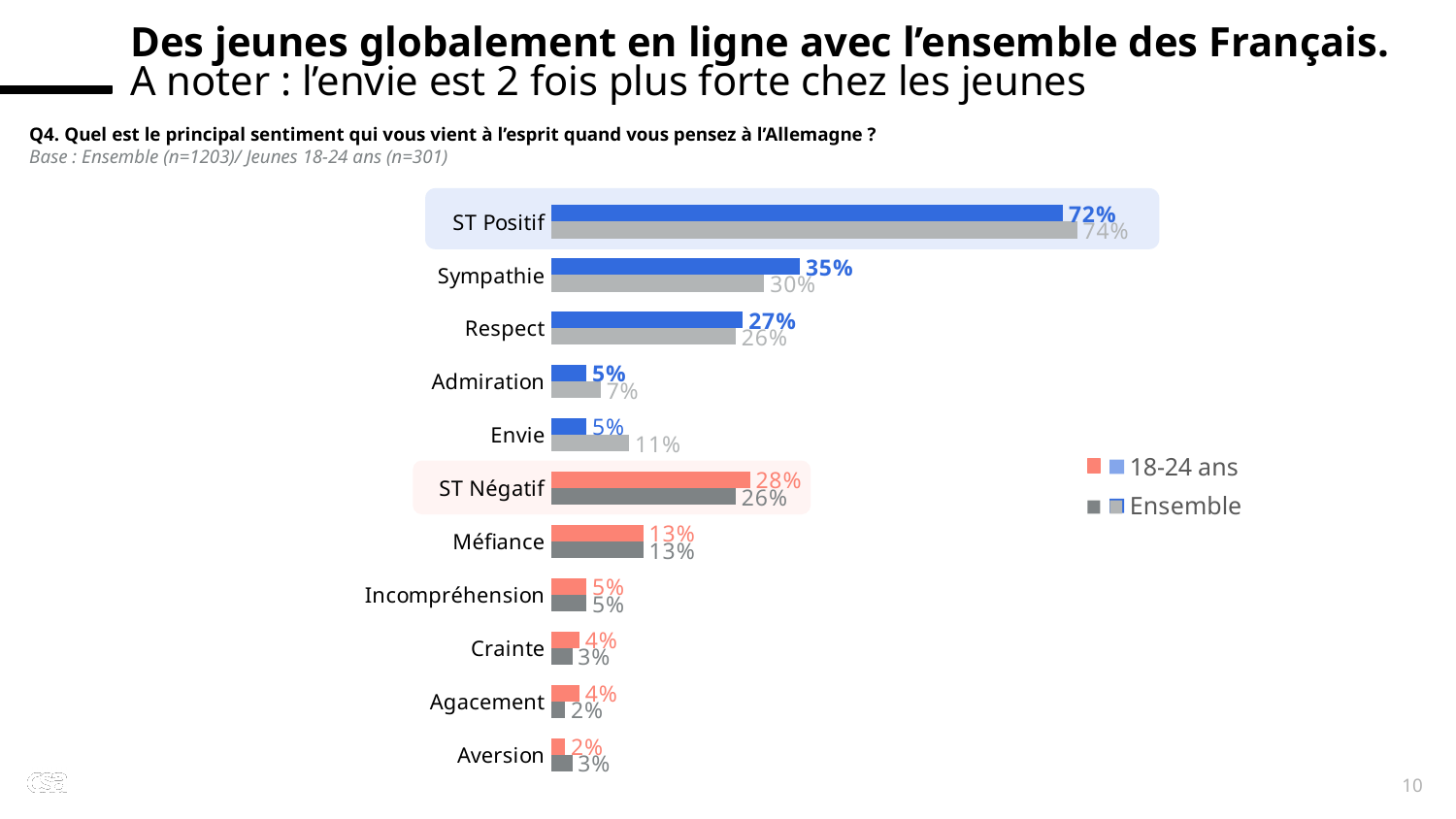
What is the value for Envie in the Ensemble series? 11% What are the two series named in the legend? 18-24 ans and Ensemble Which category has the highest value in the Ensemble series? ST Positif Which category has the lowest value in the 18-24 ans series? Aversion What is the value for Agacement in the Ensemble series? 2% What is the value for Sympathie in the 18-24 ans series? 35% How many series does the legend list? 2 What is the difference between the Ensemble and 18-24 ans values for Envie? 6% What is the value for ST Négatif in the 18-24 ans series? 28% Which is larger for Sympathie: the 18-24 ans value or the Ensemble value? 18-24 ans What kind of chart is shown on the slide? Bar chart How many categories are shown on the chart? 11